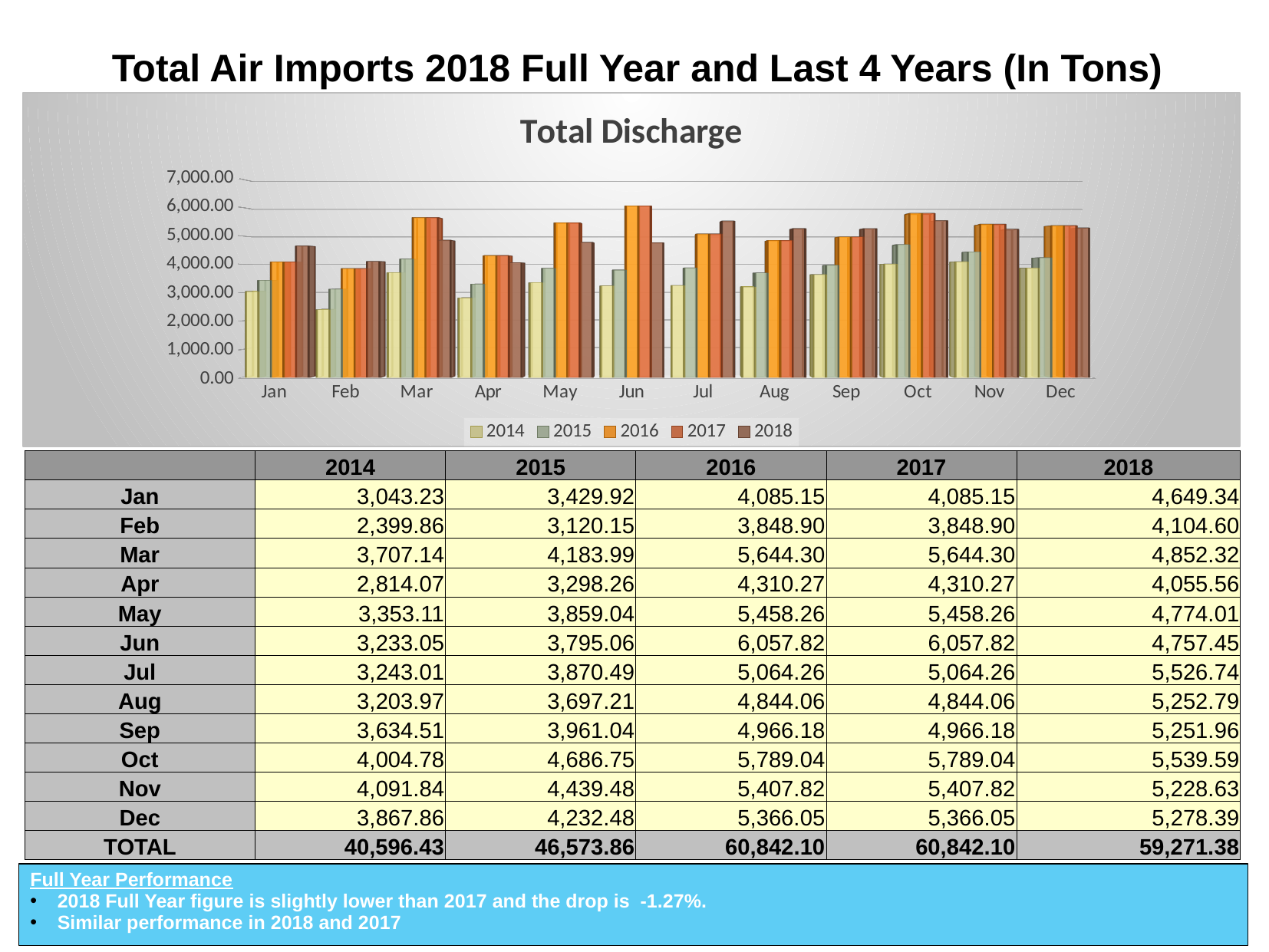
Which month has the lowest value in the 2014 series? Feb What is the title of the chart? Total Discharge For Mar, which series has the larger value, 2016 or 2018? 2016 Which month has the highest value in the 2018 series? Oct What is the TOTAL for the 2018 series? 59,271.38 What is the value for Jan in the 2018 series? 4,649.34 What is the value for Jun in the 2016 series? 6,057.82 What type of chart is shown on the slide? bar chart How many series does the chart legend list? 5 How many months (categories) are shown on the x axis of the chart? 12 Is the value for Jun in the 2016 series greater or less than 6,000.00? greater What is the difference between the Jan values for 2018 and 2014? 1,606.11